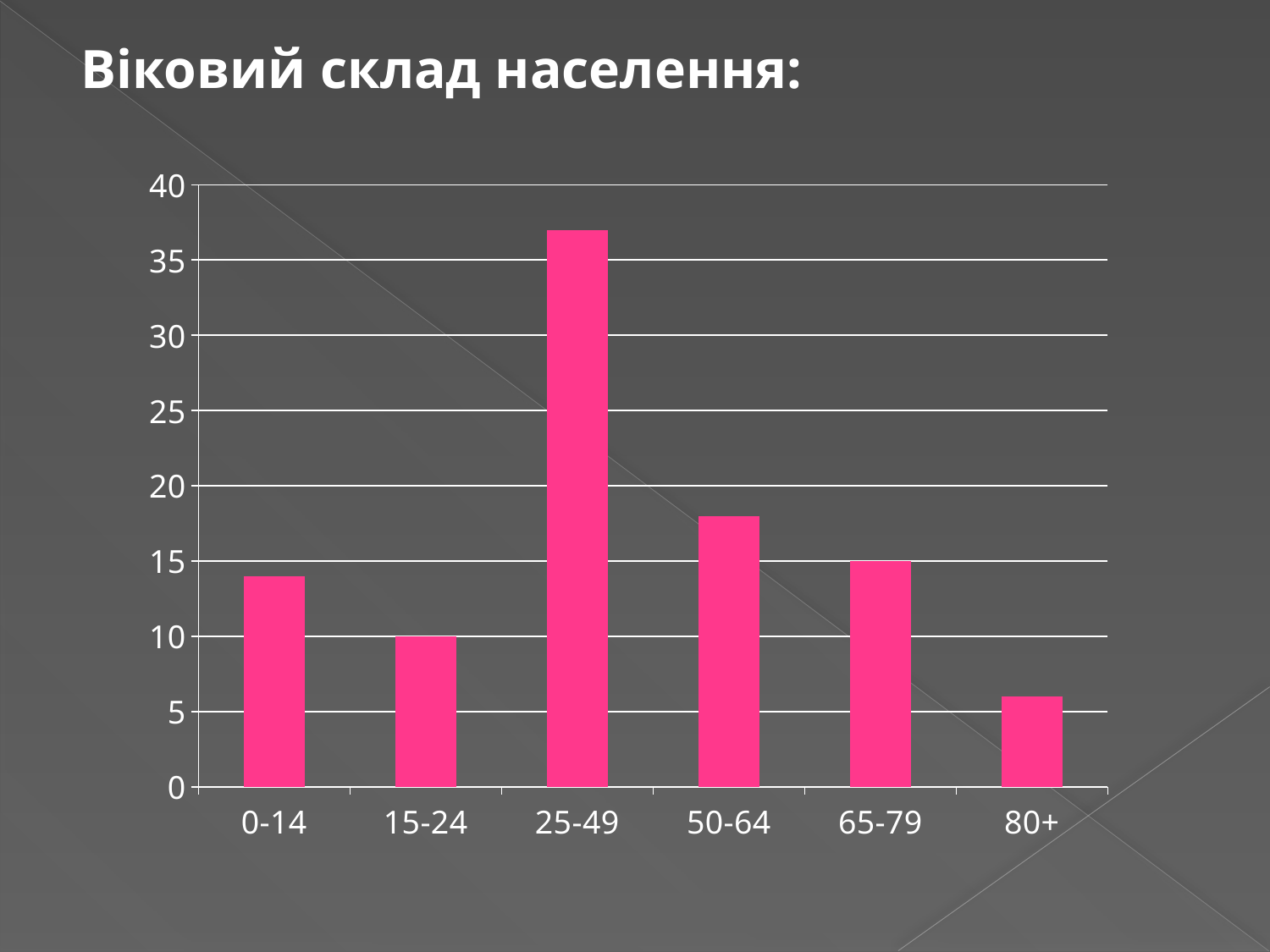
Which is larger, the value for 50-64 or the value for 65-79? 50-64 Is the value for 25-49 greater or less than 35? greater What is the title of the chart? Віковий склад населення: Which age category has the highest bar? 25-49 What is the value for the 15-24 category? 10 How many age categories are shown on the x axis? 6 What kind of chart is shown on the slide? bar chart Is the value for 80+ greater or less than 5? greater What colour are the bars in the chart? pink Is the value for 0-14 greater or less than 15? less What is the value for the 65-79 category? 15 Which age category has the lowest bar? 80+